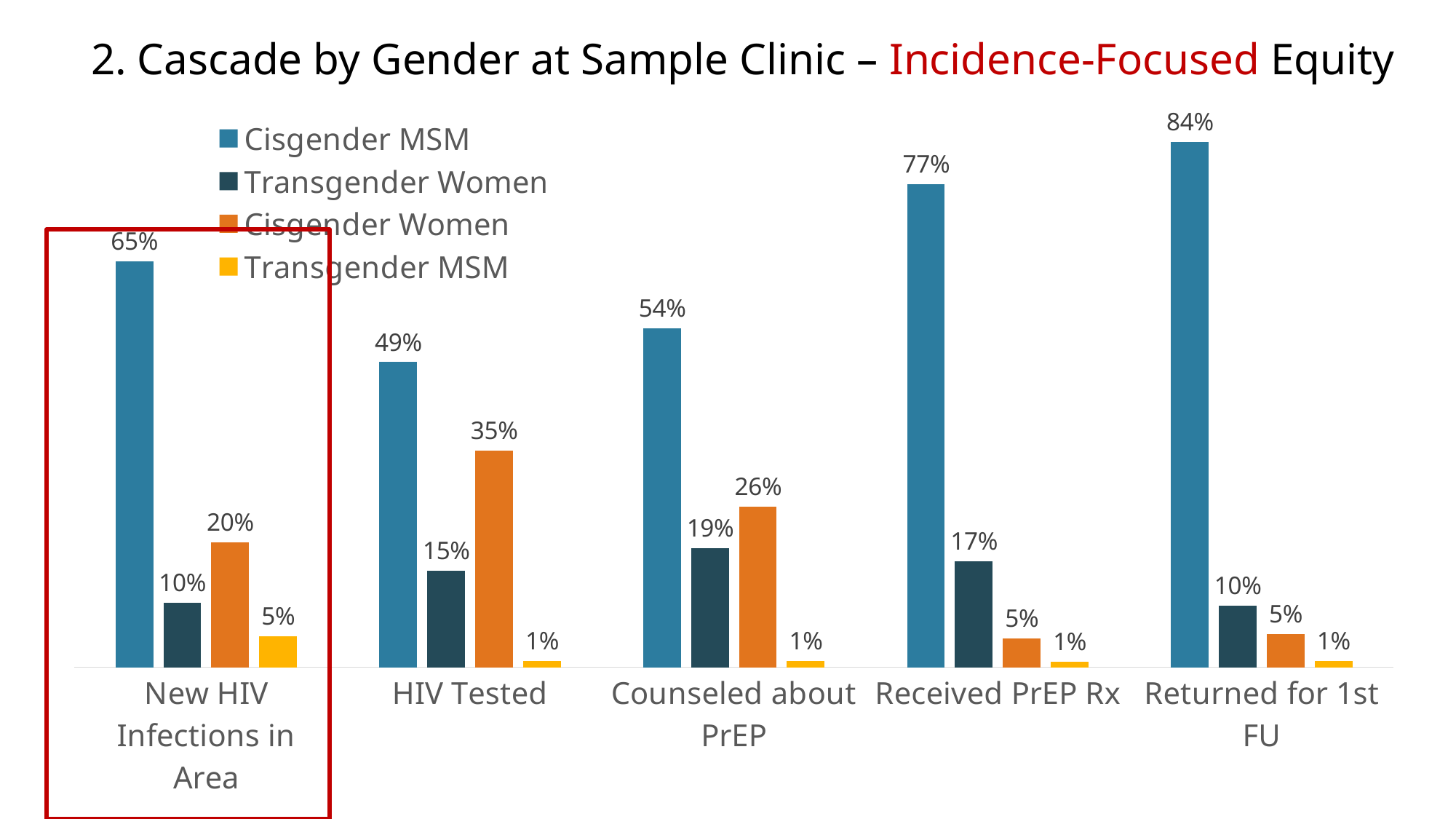
What is the value for Cisgender MSM in the New HIV Infections in Area category? 65% What is the value for Transgender Women in the Counseled about PrEP category? 19% What is the difference between the Cisgender MSM and Cisgender Women values in the Received PrEP Rx category? 72% How many series does the legend list? 4 Which category is highlighted with a red box on the slide? New HIV Infections in Area What kind of chart is shown on the slide? Bar chart Which is larger: Transgender Women in HIV Tested or Transgender Women in Received PrEP Rx? Transgender Women in Received PrEP Rx Which series has the lowest value in the HIV Tested category? Transgender MSM What is the value for Cisgender Women in the HIV Tested category? 35% In which category does Cisgender MSM have its highest value? Returned for 1st FU How many categories are shown on the x axis? 5 What is the value for Transgender MSM in the Received PrEP Rx category? 1%